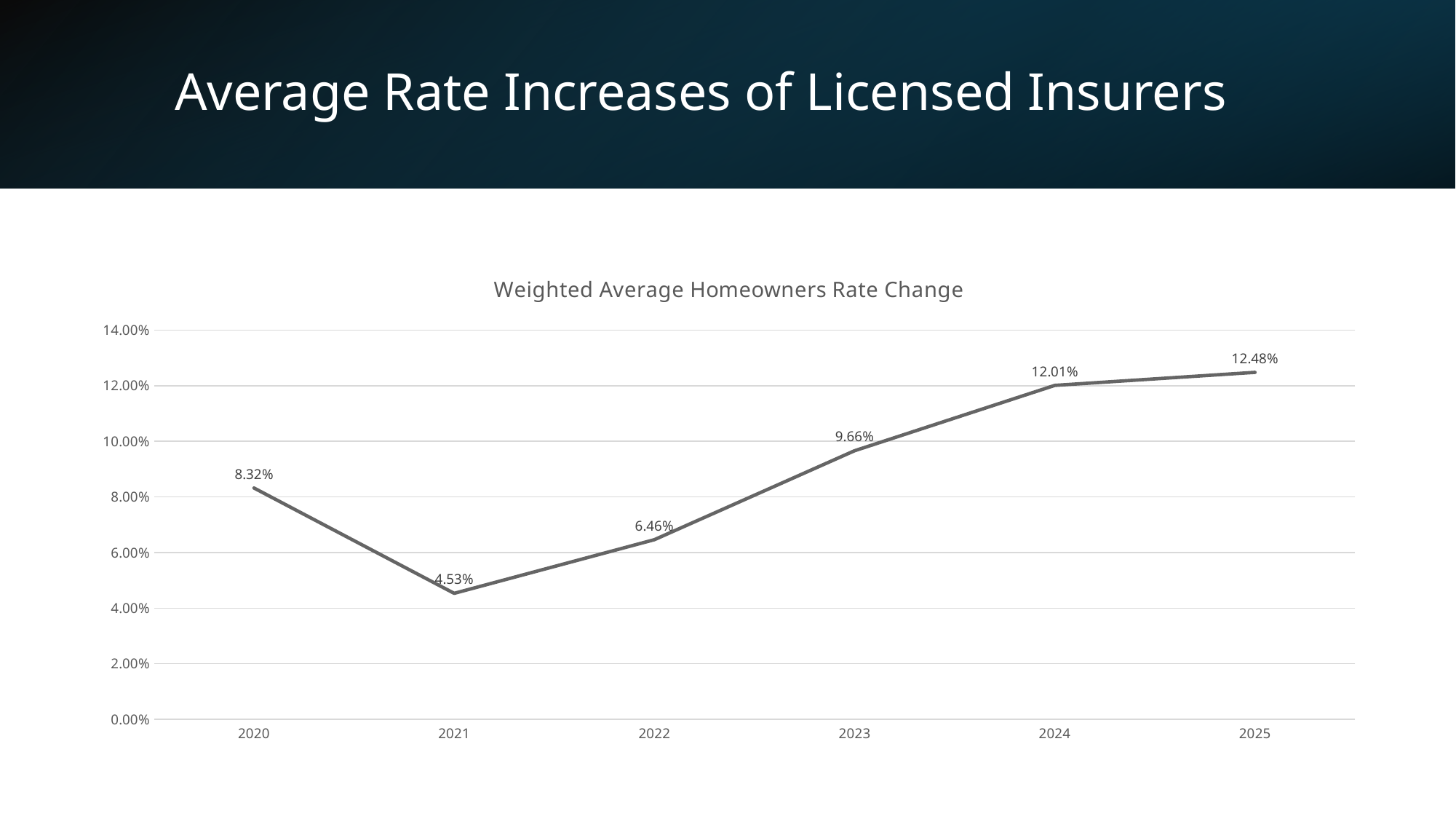
What is the weighted average homeowners rate change for 2025? 12.48% Which year has the lowest weighted average homeowners rate change? 2021 What is the weighted average homeowners rate change for 2020? 8.32% What is the weighted average homeowners rate change for 2023? 9.66% What is the difference between the rate change in 2024 and the rate change in 2021? 7.48% How many years are plotted on the chart? 6 Is the value for 2022 greater or less than 8.00%? less Which year has the highest weighted average homeowners rate change? 2025 Which year has a larger rate change, 2022 or 2023? 2023 What kind of chart is shown on the slide? line chart Do the values rise or fall from 2021 to 2025? rise What is the title of the chart? Weighted Average Homeowners Rate Change